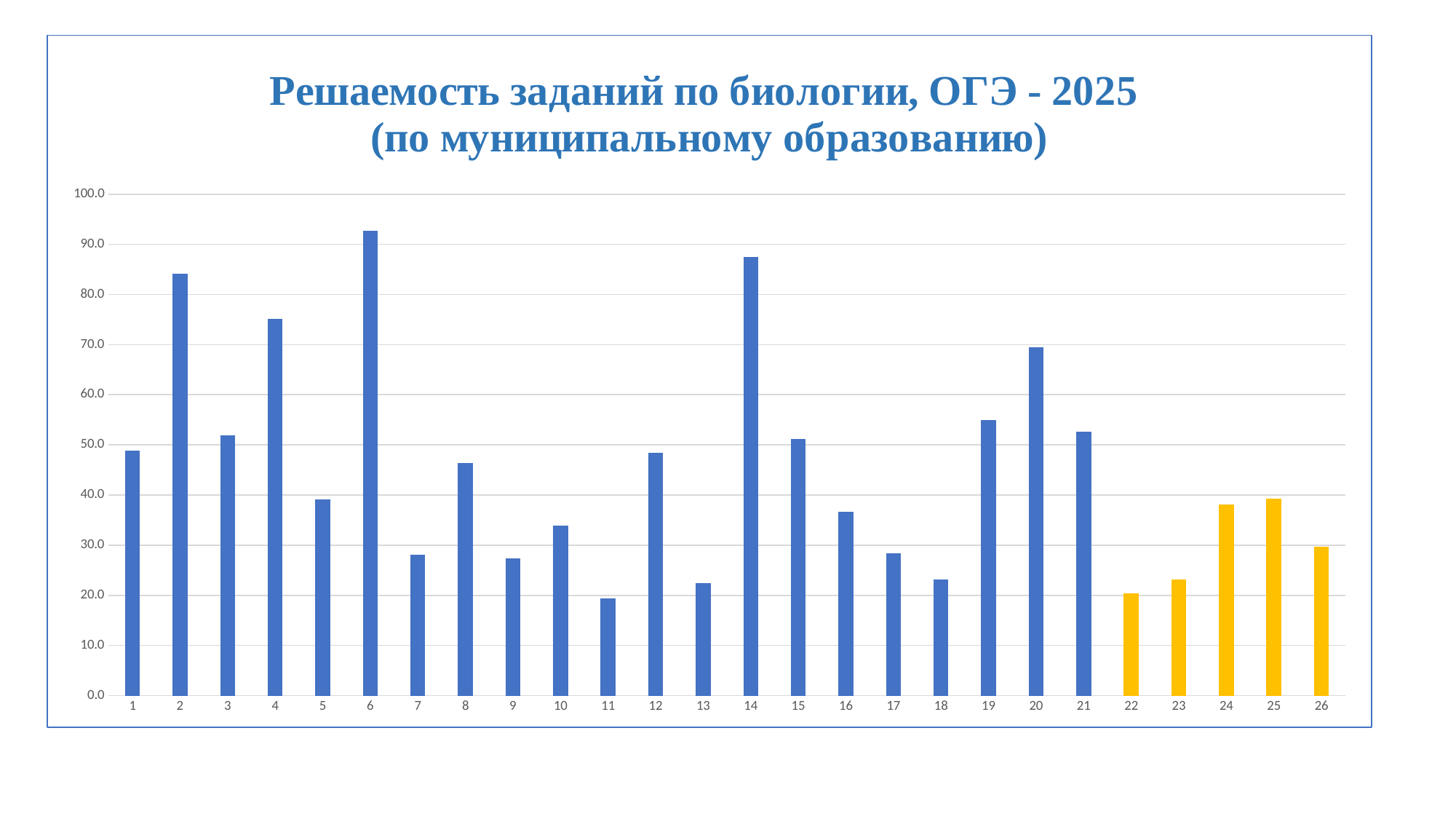
Which tasks are shown with yellow bars instead of blue? 22, 23, 24, 25, 26 How many tasks (categories) are shown on the x axis? 26 Which task has the highest value? 6 What kind of chart is shown on the slide? bar chart Is the value for task 2 greater or less than 80? greater Is the value for task 6 greater or less than 90? greater Which task has the lowest value? 11 Is the value for task 24 greater or less than 30? greater Which is larger, the value for task 13 or the value for task 26? task 26 Which is larger, the value for task 14 or the value for task 4? task 14